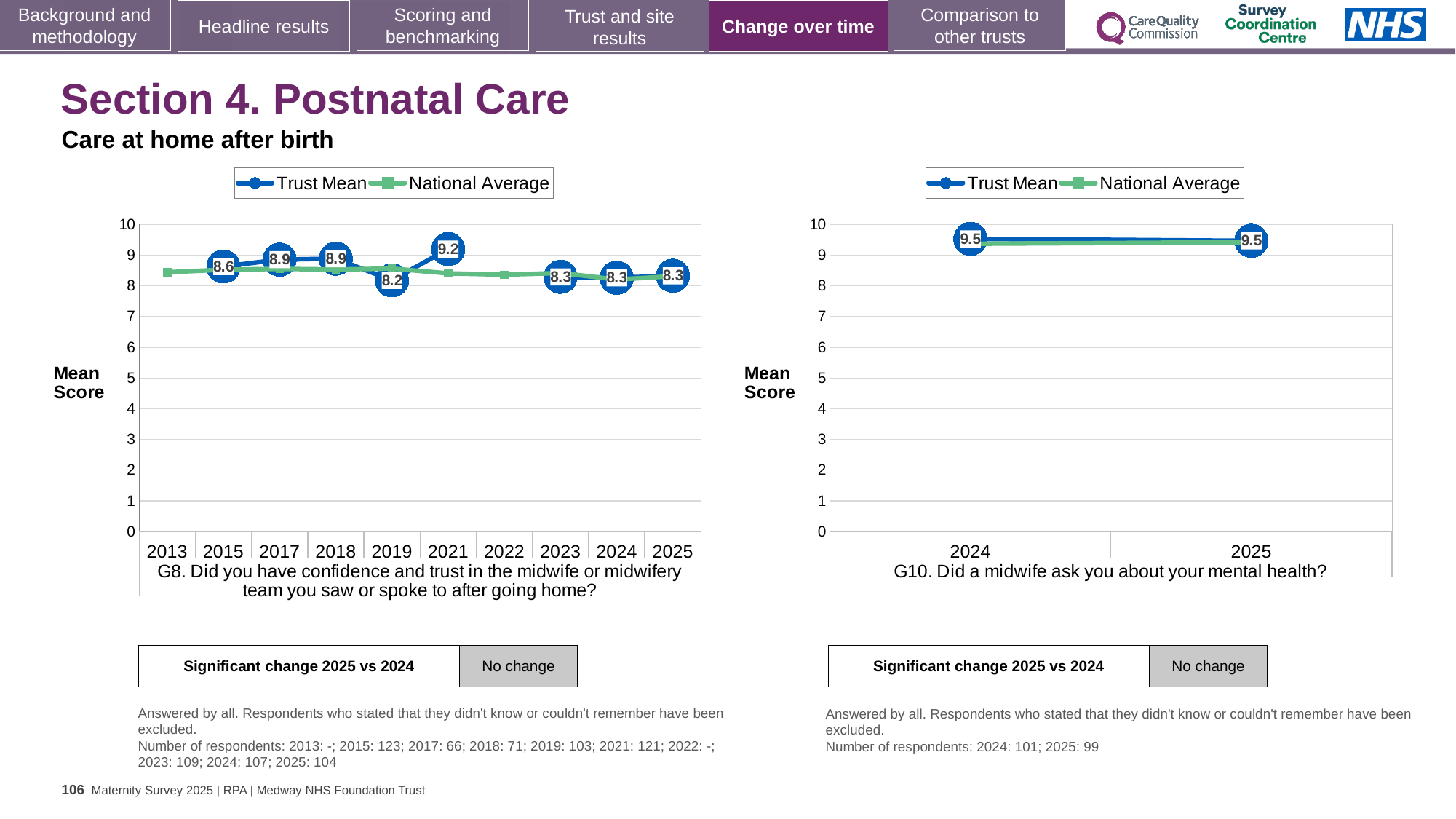
On the G8 chart (left), what is the Trust Mean score for 2019? 8.2 What type of chart is the G10 chart on the right? Line chart On the G10 chart (right), how many series does the legend list? 2 On the G10 chart (right), what is the Trust Mean score for 2025? 9.5 On the G8 chart (left), which year has the highest Trust Mean score? 2021 On the G8 chart (left), is the Trust Mean score for 2015 larger or smaller than the score for 2017? smaller On the G8 chart (left), what is the Trust Mean score for 2021? 9.2 On the G8 chart (left), how many years are shown on the x axis? 10 On the G8 chart (left), what is the Trust Mean score for 2025? 8.3 On the G8 chart (left), what is the difference between the Trust Mean scores for 2021 and 2019? 1.0 On the G8 chart (left), is the National Average for 2013 greater or less than 9? less On the G8 chart (left), which year has the lowest labelled Trust Mean score? 2019